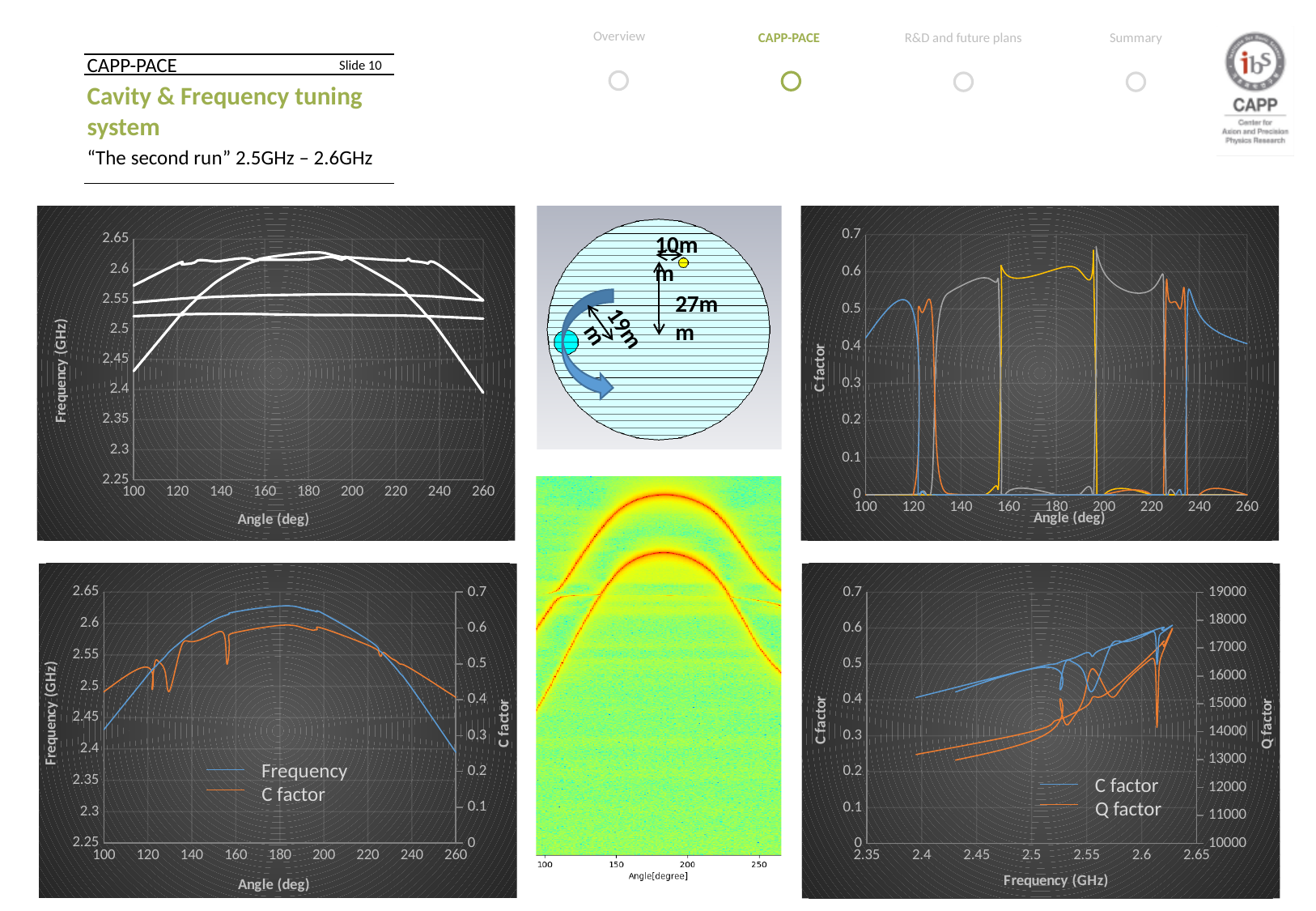
What kind of chart is the top-left chart? line chart What is the x-axis label of the bottom-right chart? Frequency (GHz) In the bottom-left chart, is the Frequency value at an angle of 180 degrees greater or less than 2.5? greater In the bottom-right chart, is the Q factor value at a frequency of 2.4 GHz greater or less than 14000? less In the bottom-right chart, is the C factor value at a frequency of 2.4 GHz greater or less than 0.3? greater In the bottom-left chart, does the Frequency series rise or fall as the angle goes from 180 to 260 degrees? fall In the bottom-left chart, how many series does the legend list? 2 In the bottom-right chart, what are the two entries in the legend? C factor, Q factor In the bottom-left chart, does the Frequency series rise or fall as the angle goes from 100 to 180 degrees? rise